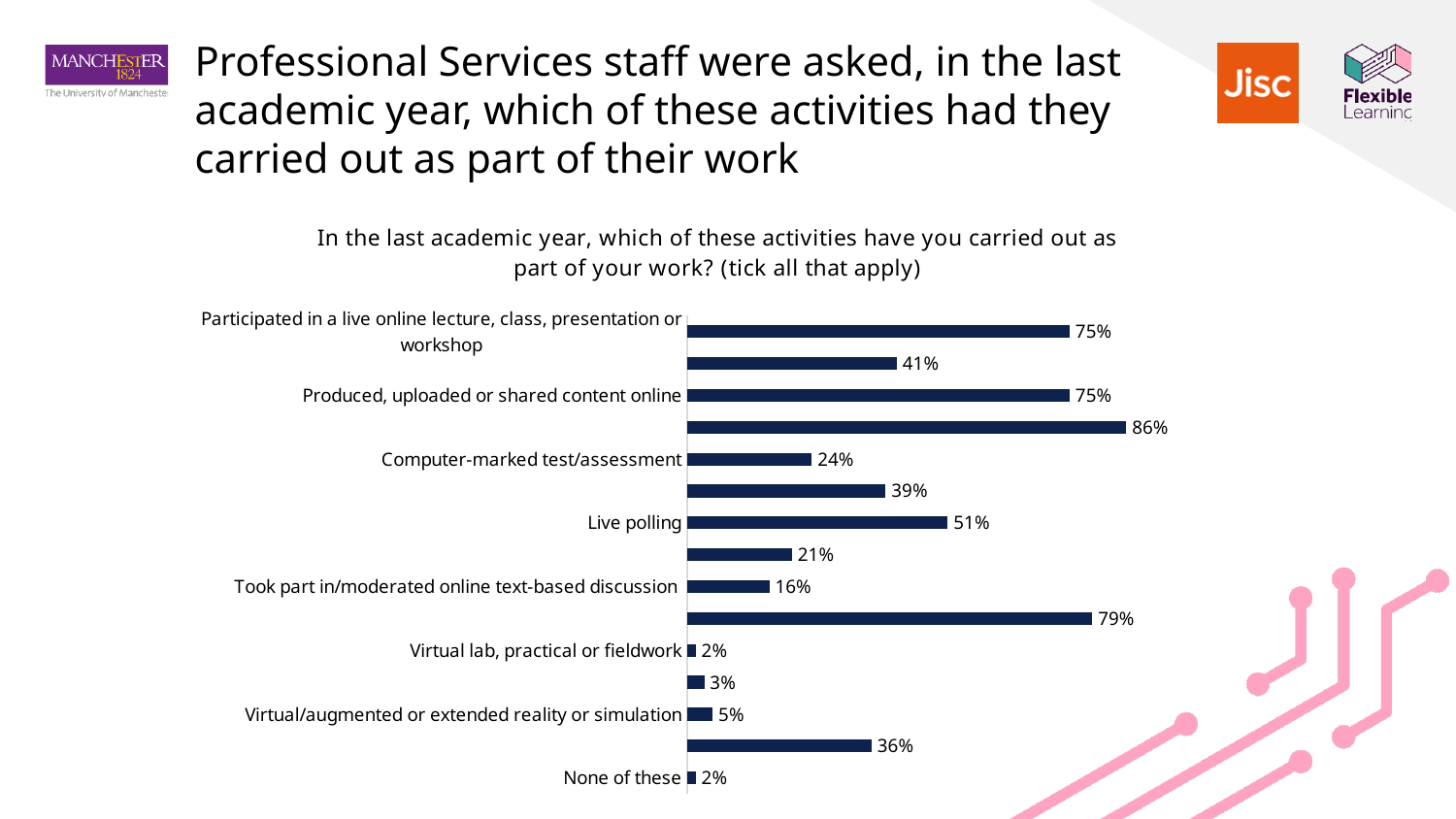
What percentage is shown for 'Computer-marked test/assessment'? 24% What is the title of the chart? In the last academic year, which of these activities have you carried out as part of your work? (tick all that apply) What is the value for 'Live polling'? 51% What is the value for 'Virtual/augmented or extended reality or simulation'? 5% What kind of chart is shown on the slide? Bar chart Which is larger: the value for 'Live polling' or the value for 'Took part in/moderated online text-based discussion'? Live polling What is the value shown for 'Produced, uploaded or shared content online'? 75% What percentage of Professional Services staff said they had participated in a live online lecture, class, presentation or workshop? 75% How many bars are plotted in the chart? 15 What percentage of respondents selected 'None of these'? 2% What is the difference between the value for 'Live polling' and the value for 'Computer-marked test/assessment'? 27% What percentage is shown for 'Took part in/moderated online text-based discussion'? 16%